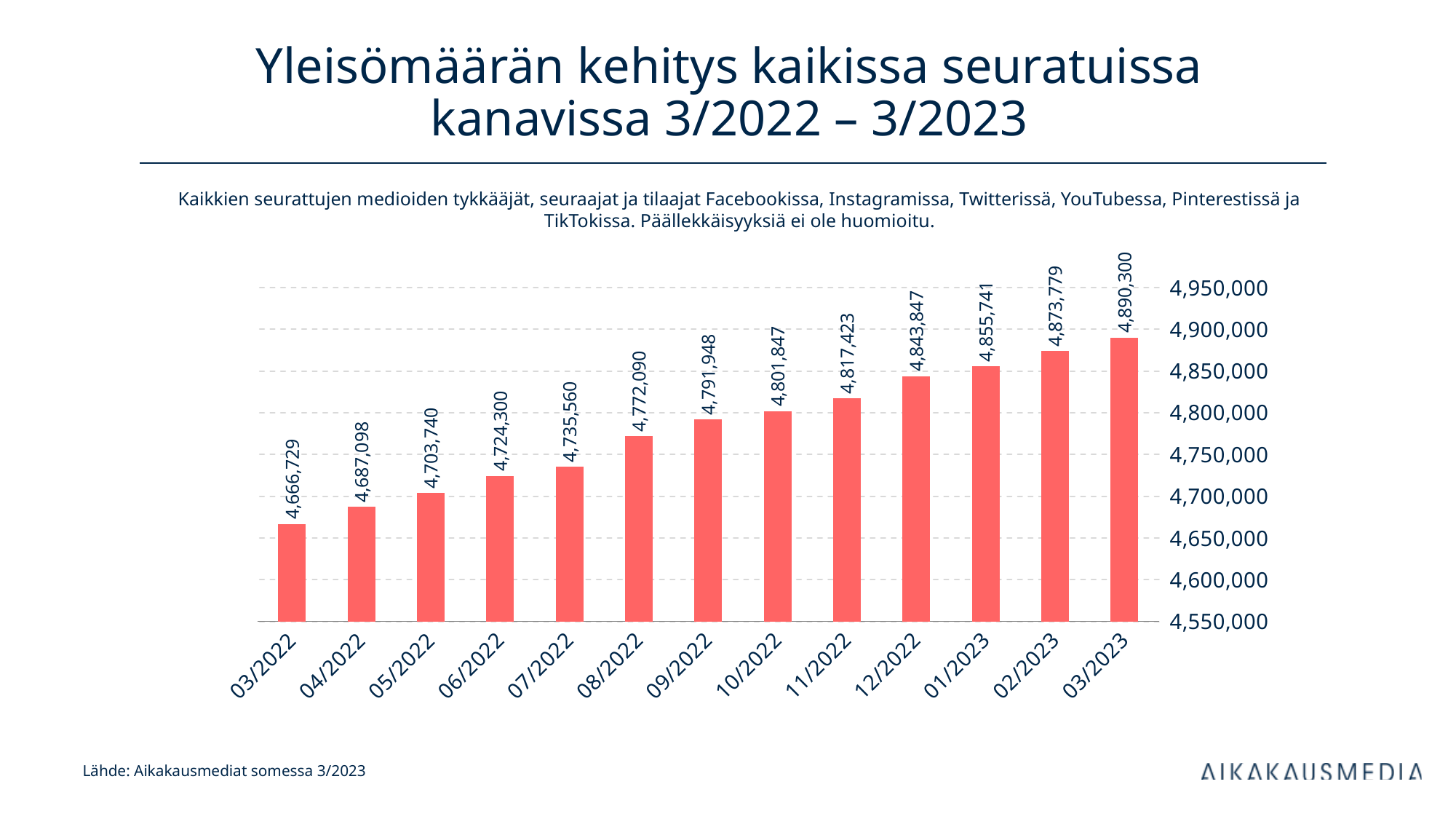
What is the value for 12/2022? 4,843,847 Which month has the highest value? 03/2023 Which month has the lowest value? 03/2022 What is the difference between the values for 08/2022 and 07/2022? 36,530 What is the difference between the values for 03/2023 and 03/2022? 223,571 What is the value for 08/2022? 4,772,090 What is the value for 03/2022? 4,666,729 What is the value for 03/2023? 4,890,300 Do the values rise or fall from 03/2022 to 03/2023? Rise Which is larger, the value for 10/2022 or the value for 06/2022? 10/2022 How many months are shown on the x axis? 13 What kind of chart is shown on the slide? Bar chart